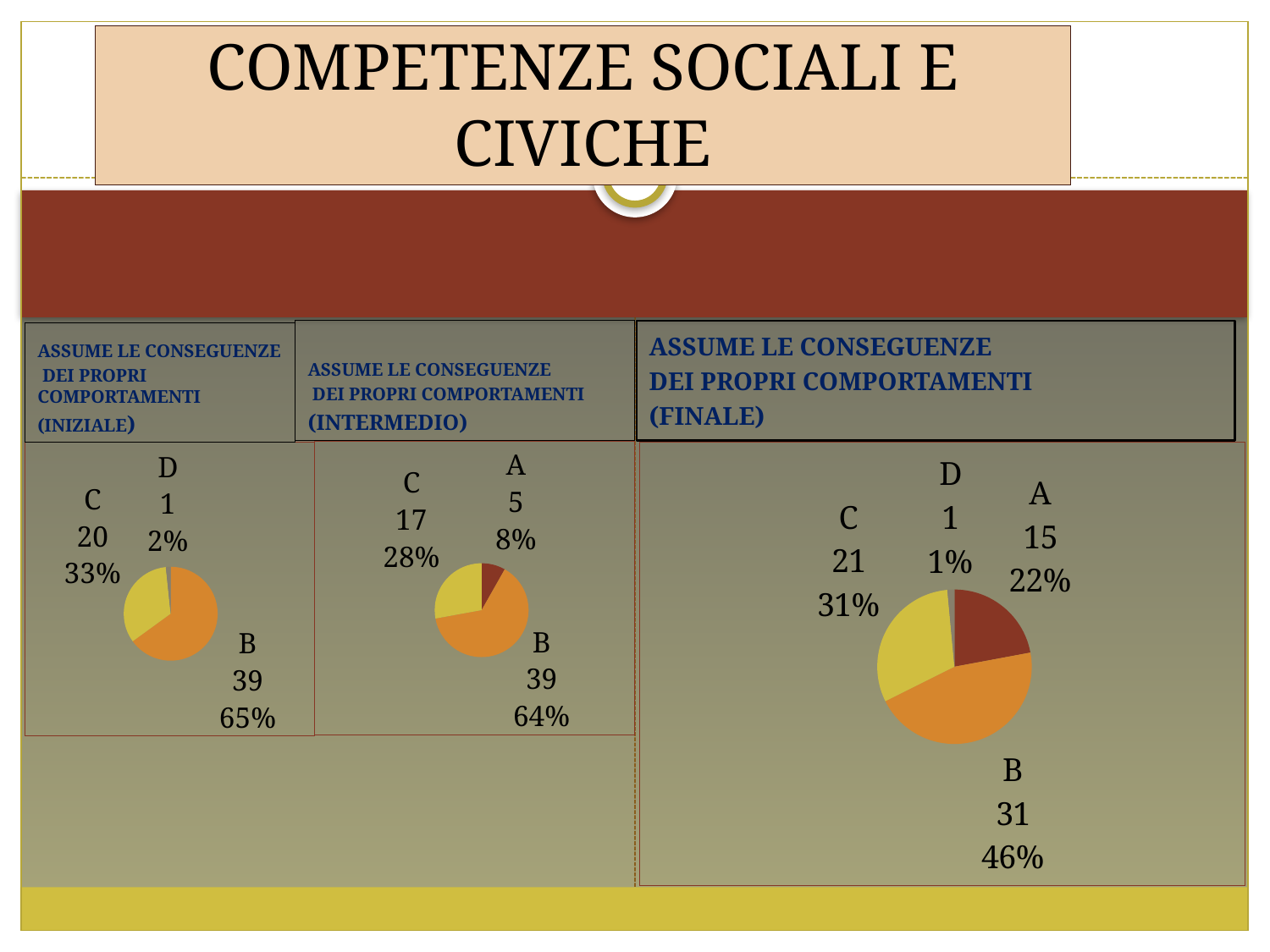
In the FINALE pie chart, which is larger, the value for C or the value for A? C In the INTERMEDIO pie chart, what is the difference between the values for B and C? 22 In the INIZIALE pie chart, which category has the smallest value? D In the INTERMEDIO pie chart, what percentage share does category B have? 64% How many categories are shown in the INTERMEDIO pie chart? 3 What type of chart is used in the FINALE panel? Pie chart In the INTERMEDIO pie chart, what is the value for category A? 5 In the FINALE pie chart, which category has the largest value? B In the FINALE pie chart, what is the value for category A? 15 In the INIZIALE pie chart, what is the value for category B? 39 In the INIZIALE pie chart, what percentage share does category C have? 33% How many categories are shown in the FINALE pie chart? 4